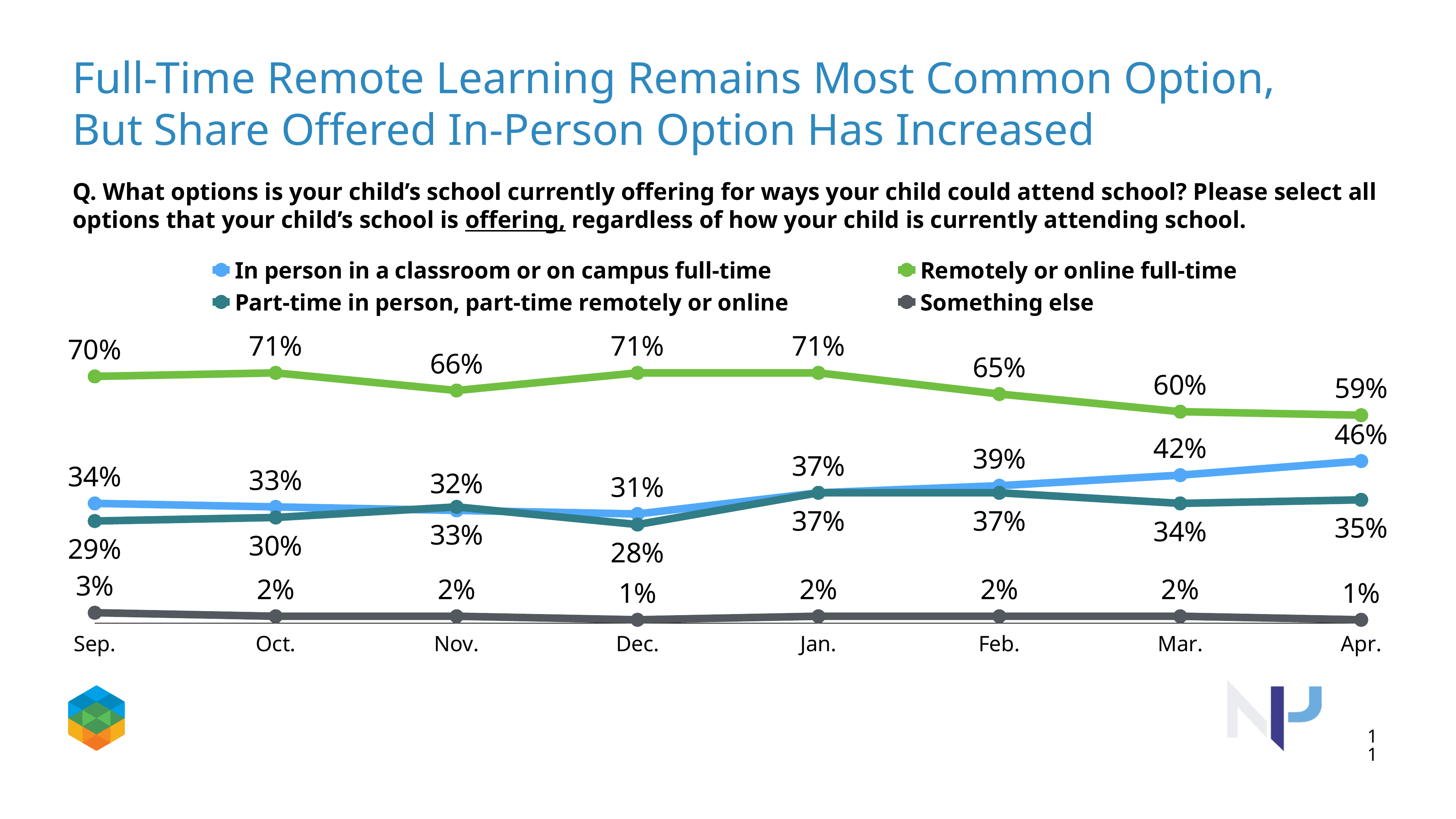
In which month is 'Remotely or online full-time' lowest? Apr. What type of chart is shown on the slide? line chart What is the value for 'Something else' in Dec.? 1% What is the value for 'In person in a classroom or on campus full-time' in Sep.? 34% Does the 'In person in a classroom or on campus full-time' series rise or fall from Dec. to Apr.? rise What is the value for 'Remotely or online full-time' in Apr.? 59% In which month is 'In person in a classroom or on campus full-time' highest? Apr. How many months are shown on the x axis? 8 What is the difference between the 'Remotely or online full-time' values in Sep. and Apr.? 11 percentage points What colour is the line for 'Remotely or online full-time'? green How many series does the legend list? 4 Which series has the higher value in Mar.: 'In person in a classroom or on campus full-time' or 'Part-time in person, part-time remotely or online'? In person in a classroom or on campus full-time